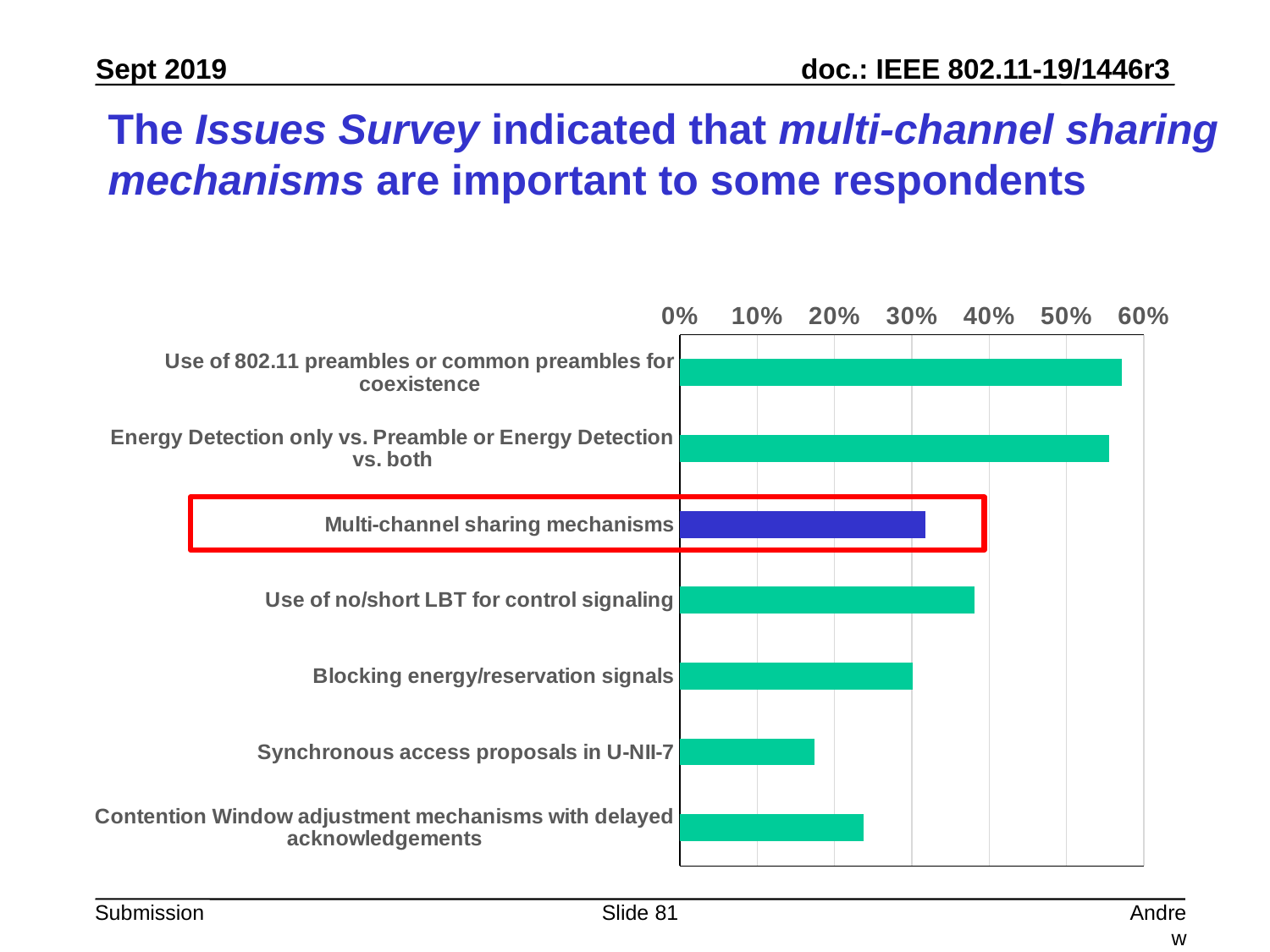
Which category has the lowest value in the chart? Synchronous access proposals in U-NII-7 Is the value for Multi-channel sharing mechanisms greater or less than 40%? less Which category has the highest value in the chart? Use of 802.11 preambles or common preambles for coexistence Is the value for Synchronous access proposals in U-NII-7 greater or less than 20%? less How many categories are plotted in the chart? 7 Is the value for Use of 802.11 preambles or common preambles for coexistence greater or less than 50%? greater Which has the larger value: Multi-channel sharing mechanisms or Use of no/short LBT for control signaling? Use of no/short LBT for control signaling What kind of chart is shown on the slide? bar chart Which category's bar is drawn in a different colour (blue) and outlined with a red box? Multi-channel sharing mechanisms Which has the larger value: Synchronous access proposals in U-NII-7 or Contention Window adjustment mechanisms with delayed acknowledgements? Contention Window adjustment mechanisms with delayed acknowledgements